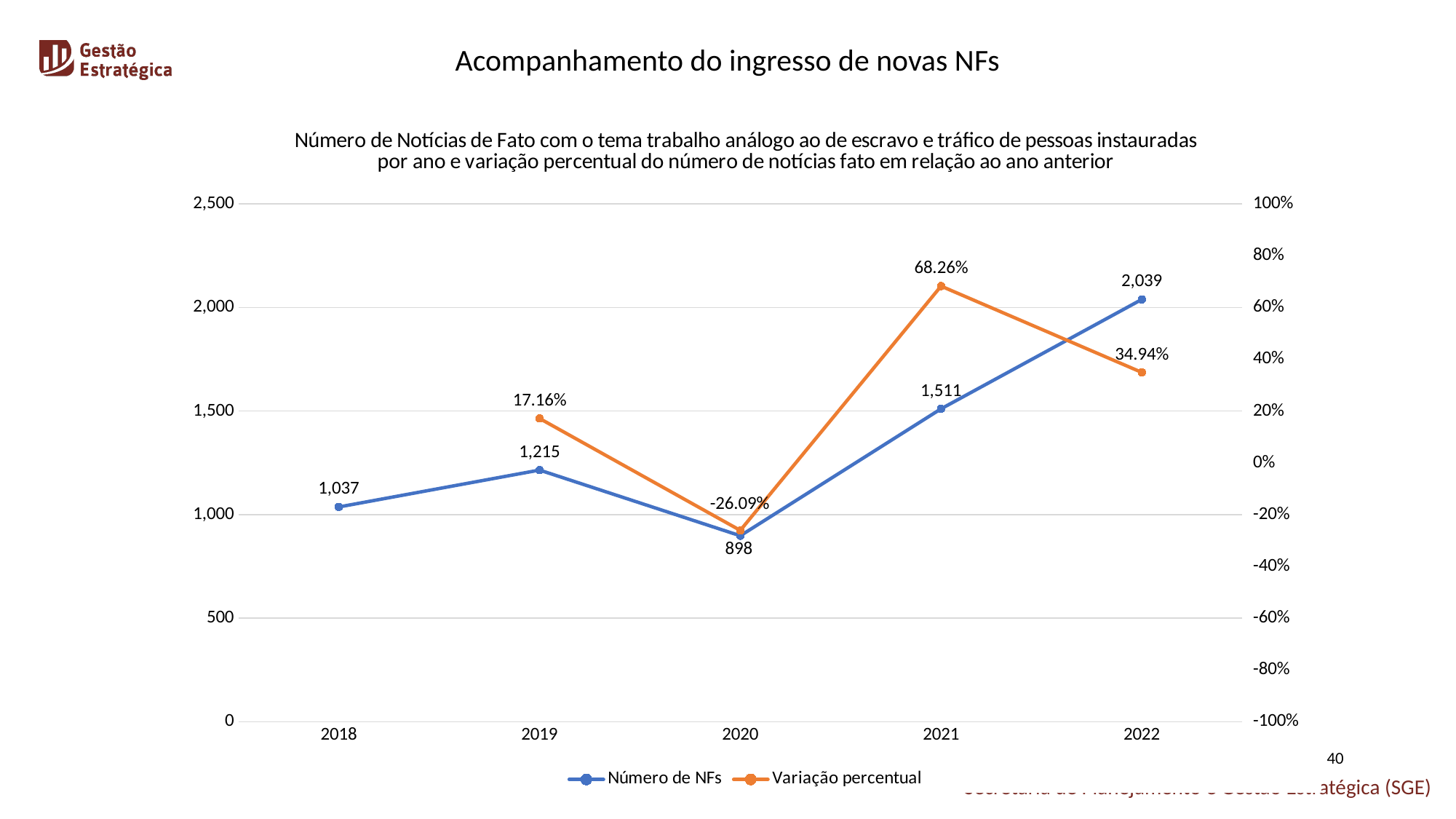
What is the difference in Número de NFs between 2022 and 2021? 528 Which is larger, the Número de NFs in 2019 or in 2021? 2021 Does the Número de NFs rise or fall from 2020 to 2022? Rise Which year has the lowest Variação percentual? 2020 What is the value of Número de NFs in 2018? 1,037 How many series does the legend list? 2 What kind of chart is shown on the slide? Line chart How many years are shown on the x axis? 5 What is the Variação percentual for 2021? 68.26% What is the value of Número de NFs in 2020? 898 Which year has the highest Número de NFs? 2022 Which colour is used for the Variação percentual series? Orange